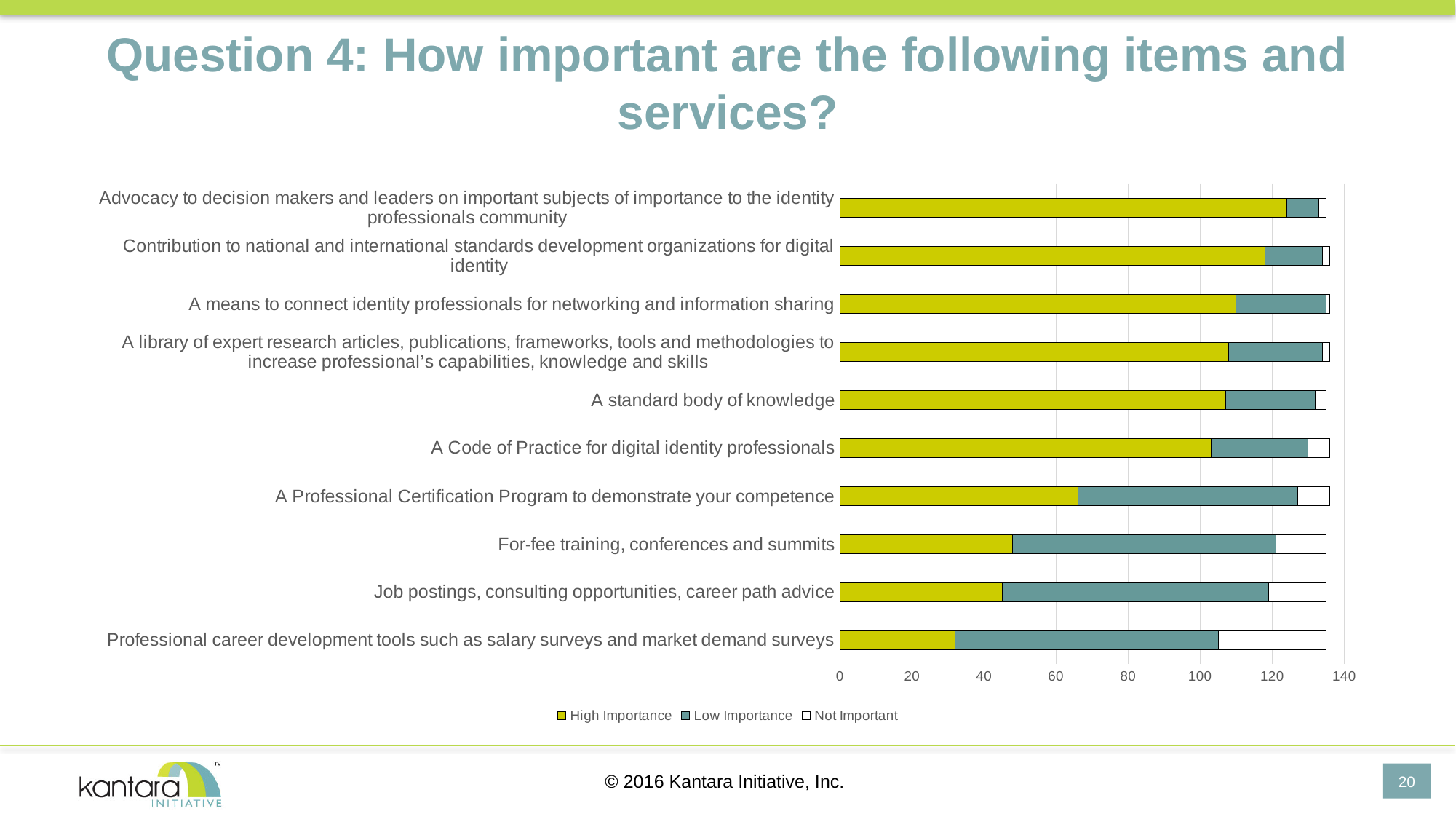
What kind of chart is shown on the slide? Stacked bar chart Which item has the smallest Low Importance value? Advocacy to decision makers and leaders on important subjects of importance to the identity professionals community How many items or services are listed as categories in the chart? 10 Which colour represents the High Importance series in the chart? Yellow-green How many series does the legend list? 3 Is the High Importance value for 'For-fee training, conferences and summits' greater or less than 60? less Is the High Importance value for 'A standard body of knowledge' greater or less than 100? greater Which item has the highest High Importance value? Advocacy to decision makers and leaders on important subjects of importance to the identity professionals community Which item has the lowest High Importance value? Professional career development tools such as salary surveys and market demand surveys Which item has the largest Not Important value? Professional career development tools such as salary surveys and market demand surveys Which has the larger High Importance value: 'Job postings, consulting opportunities, career path advice' or 'A Code of Practice for digital identity professionals'? A Code of Practice for digital identity professionals